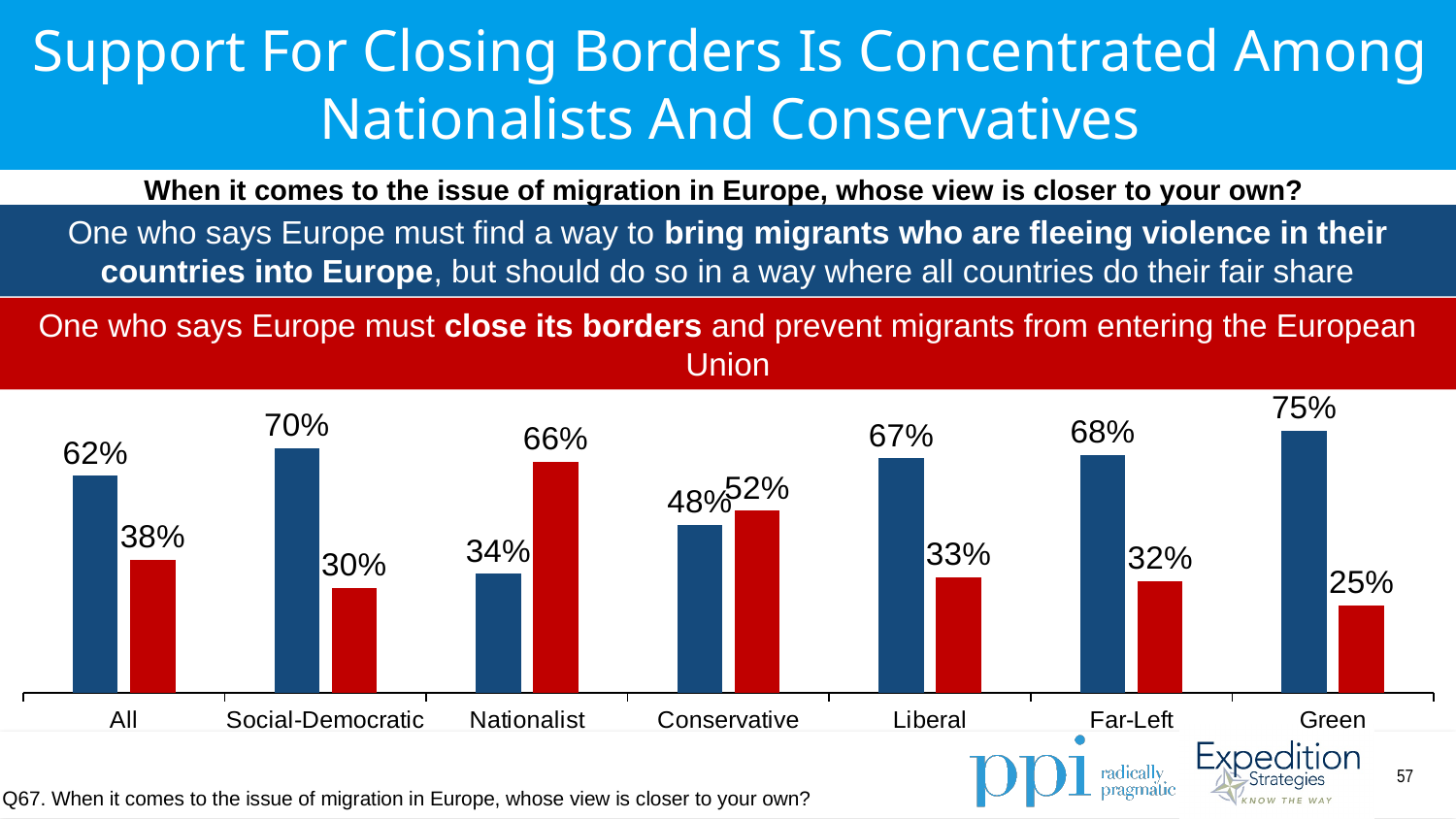
What is the difference between the blue bar for Green and the blue bar for All? 13% Which category has the highest value for the red 'close its borders' bar? Nationalist What percentage of Nationalist respondents chose the 'close its borders' view (red bar)? 66% What type of chart is shown on the slide? bar chart For the Liberal category, which is larger: the blue 'bring migrants' bar or the red 'close its borders' bar? the blue 'bring migrants' bar What percentage of All respondents chose the 'close its borders' view (red bar)? 38% What is the total of the blue and red bars for the Far-Left category? 100% What is the difference between the blue and red bars for the Conservative category? 4% Which colour represents the 'close its borders' view in the chart? red What is the value of the blue 'bring migrants' bar for the Green category? 75% Which category has the lowest value for the blue 'bring migrants' bar? Nationalist How many categories are shown on the x axis of the chart? 7